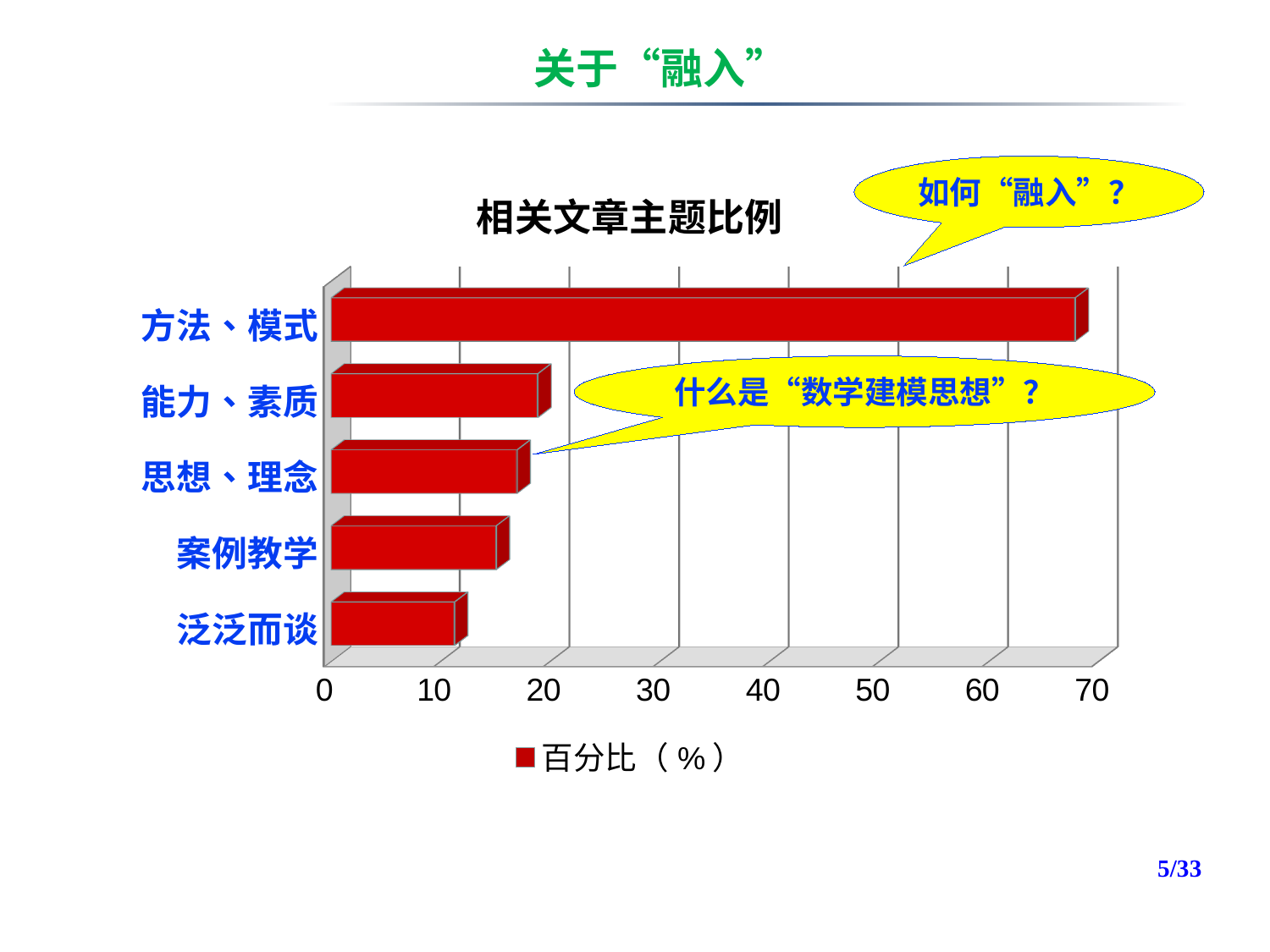
Which is larger, the value for 能力、素质 or the value for 泛泛而谈? 能力、素质 How many series does the legend list? 1 Is the value for 泛泛而谈 greater or less than 20? less Which category has the lowest value? 泛泛而谈 Is the value for 案例教学 greater or less than 10? greater Going from the top category to the bottom category, do the bar values increase or decrease? decrease How many categories are plotted in the chart? 5 What is the legend entry for the series in the chart? 百分比（%） Which category has the highest value? 方法、模式 What kind of chart is shown on the slide? bar chart Is the value for 方法、模式 greater or less than 60? greater What is the title of the chart? 相关文章主题比例